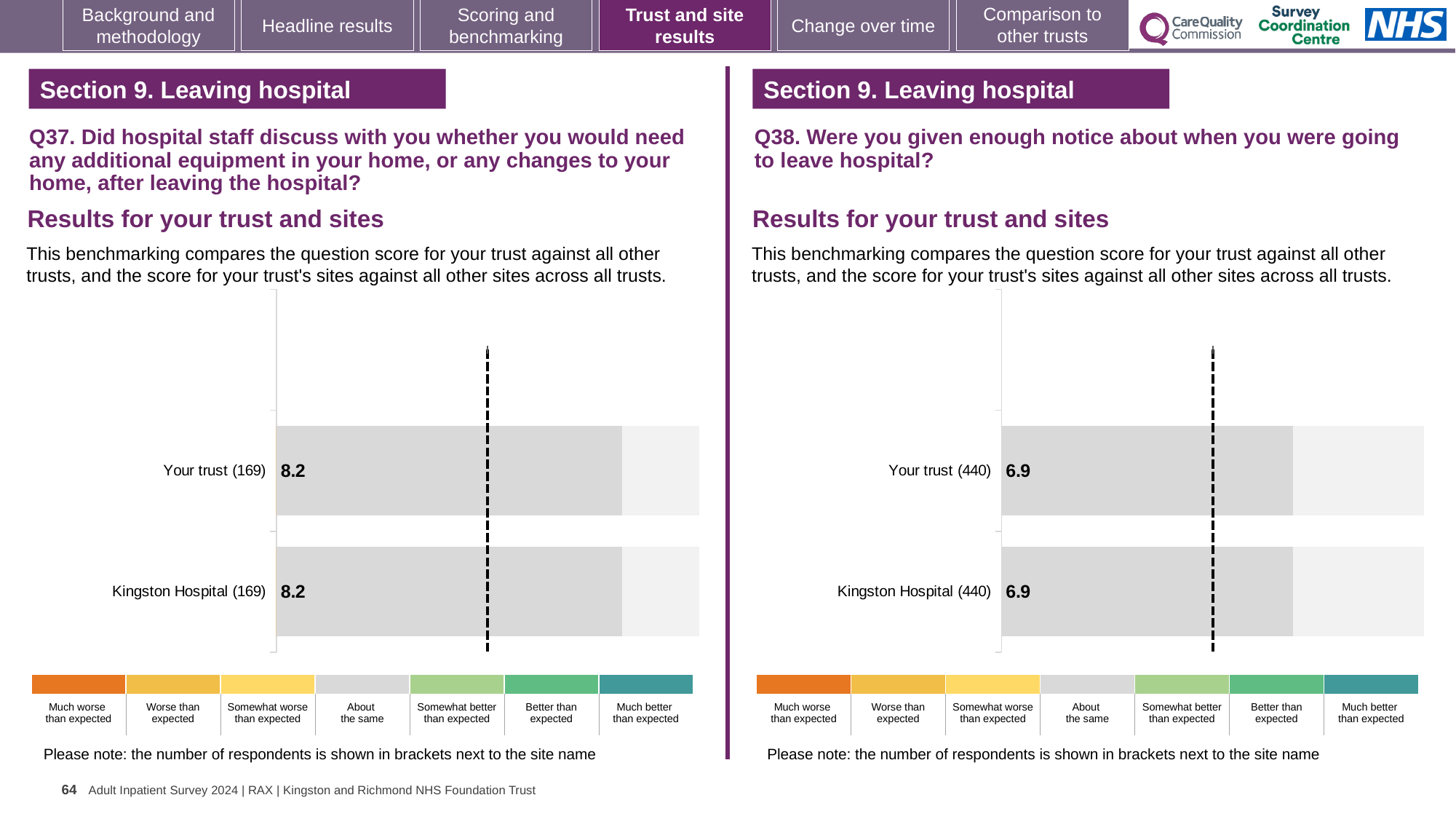
In the Q37 chart on the left, what is the difference between the score for Your trust and the score for Kingston Hospital? 0 What kind of chart is used for the Q38 results on the right? Bar chart In the Q38 chart on the right, what is the score for Kingston Hospital? 6.9 In the Q38 chart on the right, what is the difference between the score for Your trust and the score for Kingston Hospital? 0 In the Q38 chart on the right, how many respondents are shown in brackets next to Your trust? 440 In the Q38 chart on the right, what is the score for Your trust? 6.9 In the Q37 chart on the left, what is the score for Your trust? 8.2 How many bars are plotted in the Q37 chart on the left? 2 In the Q37 chart on the left, how many respondents are shown in brackets next to Kingston Hospital? 169 In the Q37 chart on the left, what is the score for Kingston Hospital? 8.2 How many bars are plotted in the Q38 chart on the right? 2